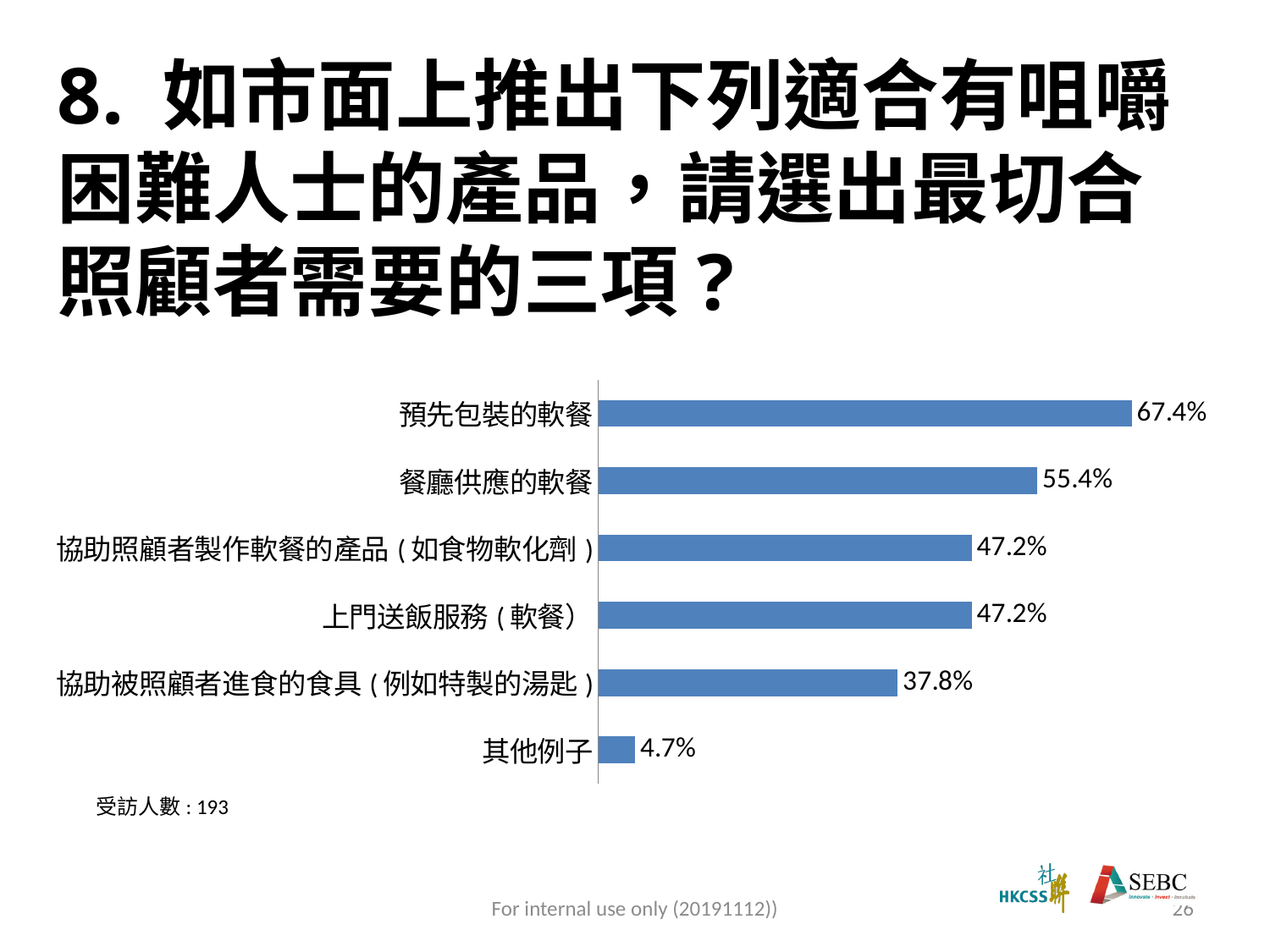
What kind of chart is shown on the slide? bar chart What is the value for 上門送飯服務 ( 軟餐)? 47.2% How many categories are shown in the chart? 6 What is the difference between the values for 預先包裝的軟餐 and 餐廳供應的軟餐? 12.0% What is the value for 餐廳供應的軟餐? 55.4% What is the value for 其他例子? 4.7% What is the difference between the values for 餐廳供應的軟餐 and 協助被照顧者進食的食具 ( 例如特製的湯匙 )? 17.6% What is the value for 預先包裝的軟餐? 67.4% Which category has the lowest value? 其他例子 Which category has the highest value? 預先包裝的軟餐 What is the value for 協助被照顧者進食的食具 ( 例如特製的湯匙 )? 37.8% Which is larger, the value for 餐廳供應的軟餐 or the value for 上門送飯服務 ( 軟餐)? 餐廳供應的軟餐